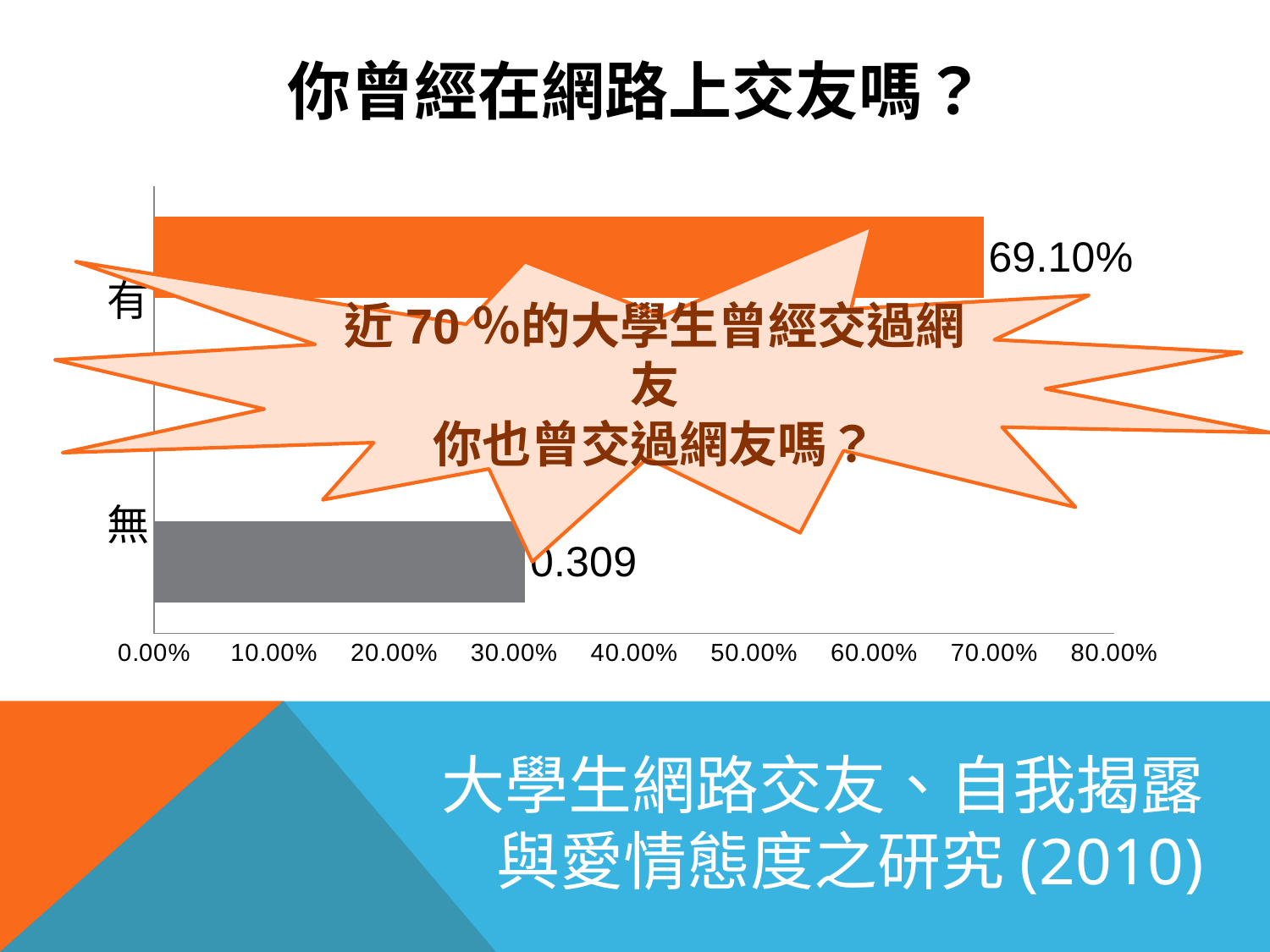
Which category has the longest bar in the chart? 有 What kind of chart is shown on the slide? bar chart What is the value shown for 有 in the chart? 69.10% Which bar is longer, 有 or 無? 有 How many categories are plotted in the chart? 2 What is the title of the chart? 你曾經在網路上交友嗎？ Which category has the shortest bar in the chart? 無 What is the data label shown on the 無 bar? 0.309 Is the value for 無 greater or less than 20.00%? greater What is the highest tick label shown on the x axis? 80.00% Is the value for 有 greater or less than 60.00%? greater Is the value for 無 greater or less than 40.00%? less